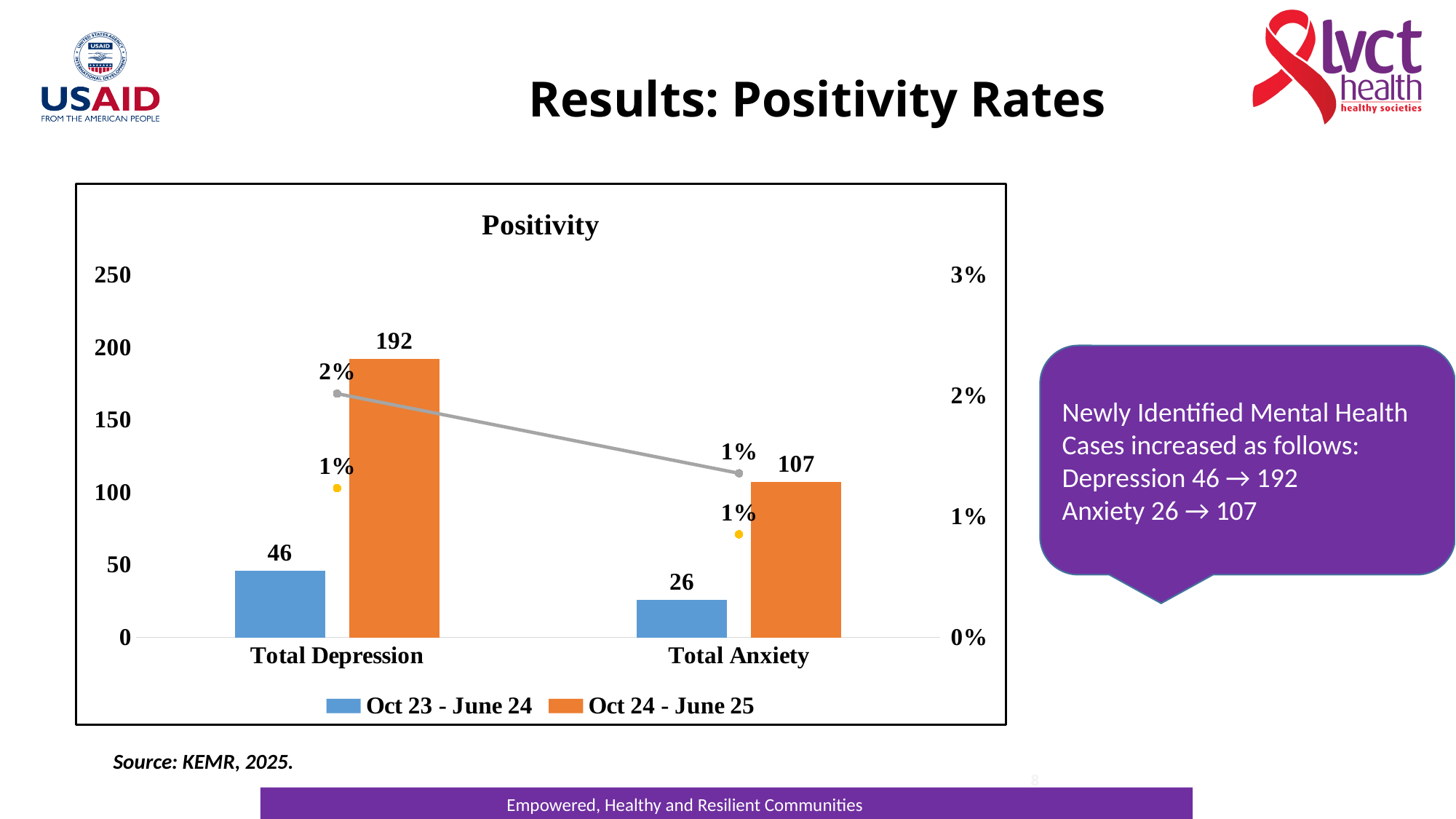
What is the difference between the Oct 24 - June 25 and Oct 23 - June 24 values for Total Anxiety? 81 What is the value for Total Anxiety in the Oct 23 - June 24 series? 26 Which is larger: the Oct 24 - June 25 value for Total Anxiety or the Oct 23 - June 24 value for Total Depression? Oct 24 - June 25 value for Total Anxiety Which category has the lowest value in the Oct 23 - June 24 series? Total Anxiety What is the title of the chart? Positivity Which category has the highest value in the Oct 24 - June 25 series? Total Depression How many series does the chart legend list? 2 How many categories are shown on the x axis of the chart? 2 What is the difference between the Oct 24 - June 25 and Oct 23 - June 24 values for Total Depression? 146 What is the value for Total Depression in the Oct 23 - June 24 series? 46 What is the value for Total Depression in the Oct 24 - June 25 series? 192 What is the value for Total Anxiety in the Oct 24 - June 25 series? 107